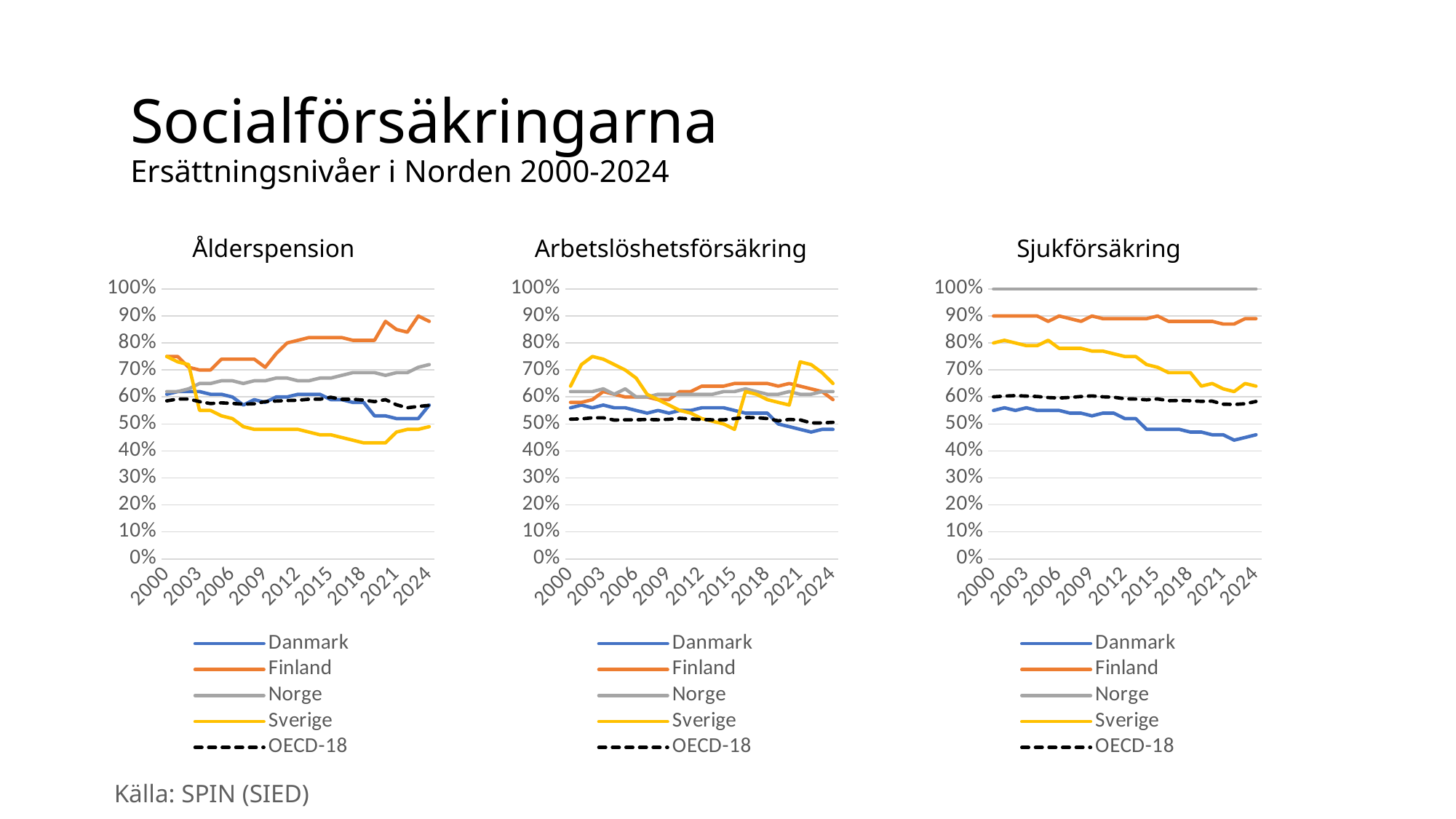
In the Arbetslöshetsförsäkring chart, is the value for Sverige in 2002 greater or less than 70%? greater In the Sjukförsäkring chart, which series has the lowest value in 2024? Danmark What kind of chart is the Ålderspension chart? line chart In the Ålderspension chart, which series has the highest value in 2024? Finland In the Ålderspension chart, is the value for Finland in 2024 greater or less than 80%? greater In the Arbetslöshetsförsäkring chart, does the Danmark line rise or fall from 2000 to 2024? fall In the Ålderspension chart, is the value for Sverige in 2020 greater or less than 50%? less In the Sjukförsäkring chart, which series has the highest values throughout the period? Norge Which series is drawn as a dashed black line in all three charts? OECD-18 In the Ålderspension chart, does the Sverige line rise or fall from 2000 to 2024? fall How many series does the legend of the Sjukförsäkring chart list? 5